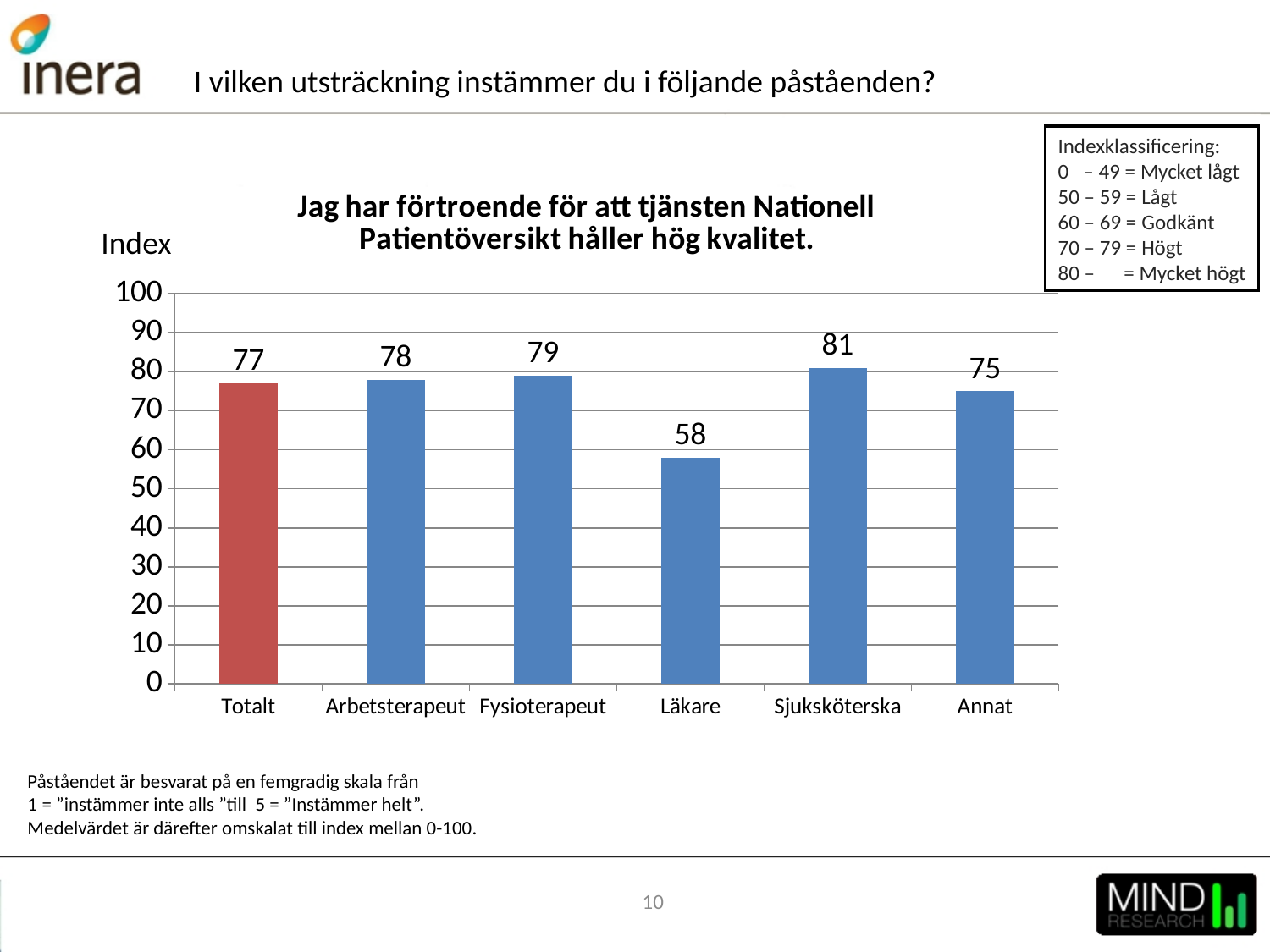
Which category has the lowest index value? Läkare What is the index value for Arbetsterapeut? 78 What kind of chart is shown on the slide? bar chart What is the index value for Totalt? 77 How many categories are shown on the x axis? 6 What is the difference between the index values for Sjuksköterska and Läkare? 23 Is the value for Läkare greater or less than 60? less Which bar is coloured differently (red) from the others? Totalt What is the index value for Sjuksköterska? 81 Which category has the highest index value? Sjuksköterska What is the index value for Läkare? 58 Which has a higher index value, Fysioterapeut or Annat? Fysioterapeut